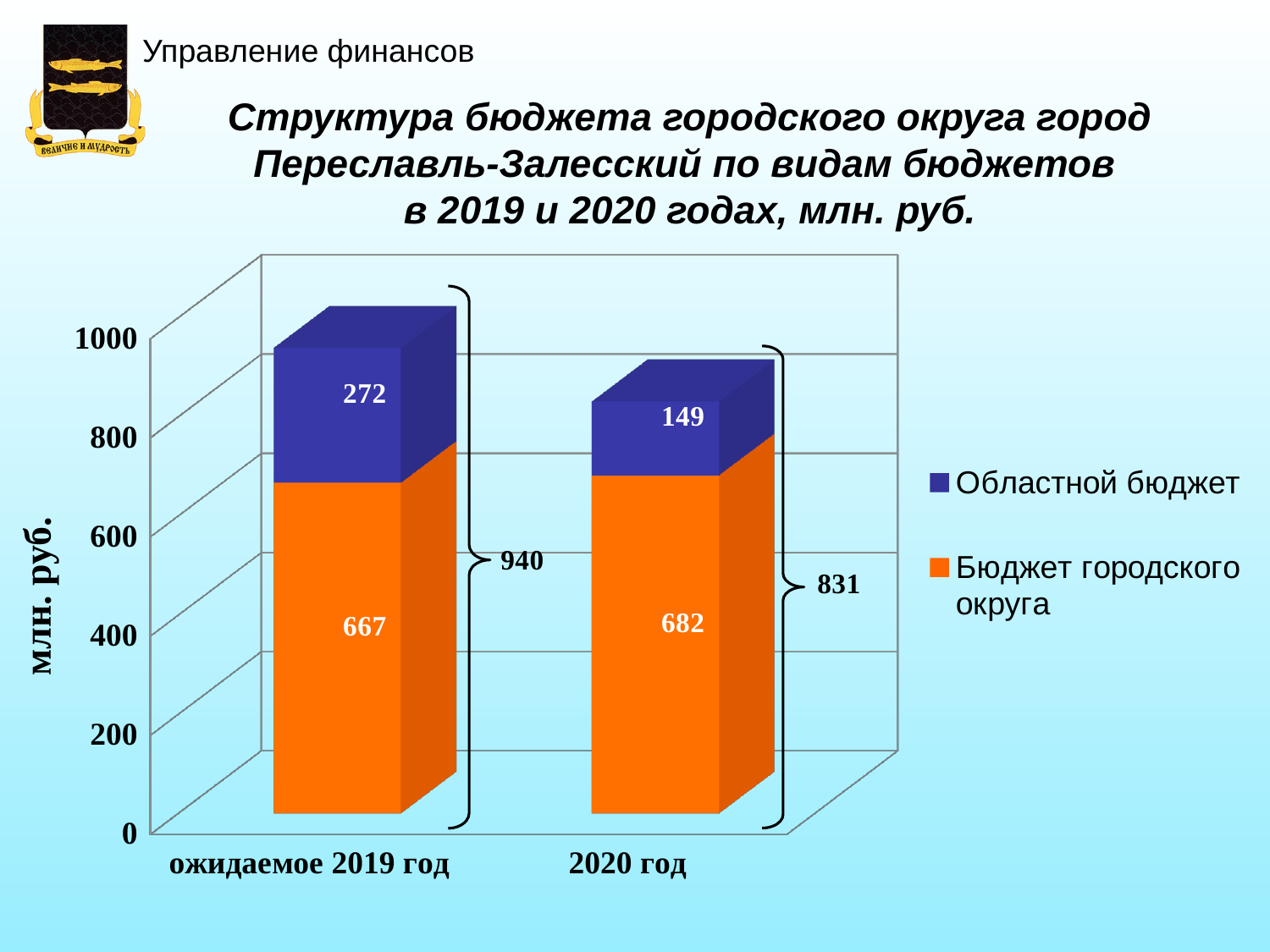
What is the label of the vertical axis? млн. руб. What total is shown next to the bar for ожидаемое 2019 год? 940 How many series does the legend list? 2 What kind of chart is shown on the slide? Stacked bar chart What is the difference between the Областной бюджет values for ожидаемое 2019 год and 2020 год? 123 What is the value of Областной бюджет for ожидаемое 2019 год? 272 What is the value of Областной бюджет for 2020 год? 149 What is the value of Бюджет городского округа for 2020 год? 682 What is the value of Бюджет городского округа for ожидаемое 2019 год? 667 What total is shown next to the bar for 2020 год? 831 Which year has the larger Бюджет городского округа value, ожидаемое 2019 год or 2020 год? 2020 год Which category has the highest Областной бюджет value? ожидаемое 2019 год